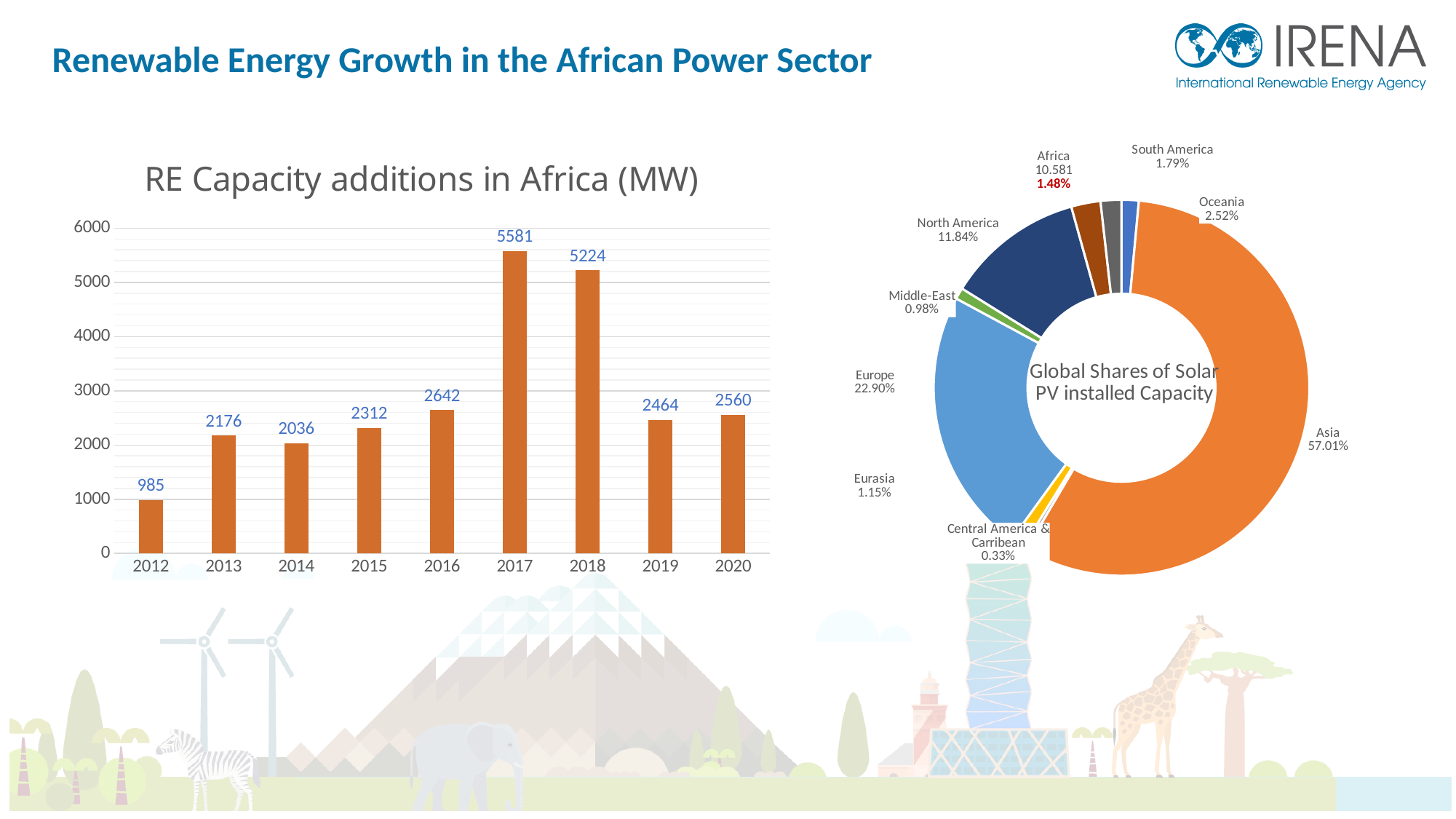
In the 'Global Shares of Solar PV installed Capacity' chart, which region has the smallest share? Central America & Carribean In the 'RE Capacity additions in Africa (MW)' chart, which year has the highest value? 2017 In the 'RE Capacity additions in Africa (MW)' chart, which year has the lowest value? 2012 In the 'RE Capacity additions in Africa (MW)' chart, what is the value for 2017? 5581 In the 'Global Shares of Solar PV installed Capacity' chart, what is the share for Asia? 57.01% In the 'RE Capacity additions in Africa (MW)' chart, what is the value for 2012? 985 In the 'RE Capacity additions in Africa (MW)' chart, which year has the larger value, 2019 or 2020? 2020 In the 'RE Capacity additions in Africa (MW)' chart, what is the difference between the values for 2017 and 2018? 357 In the 'Global Shares of Solar PV installed Capacity' chart, which region has the larger share, North America or Africa? North America In the 'RE Capacity additions in Africa (MW)' chart, how many years are shown on the x axis? 9 In the 'Global Shares of Solar PV installed Capacity' chart, what is the share for Europe? 22.90% What kind of chart is 'RE Capacity additions in Africa (MW)'? Bar chart